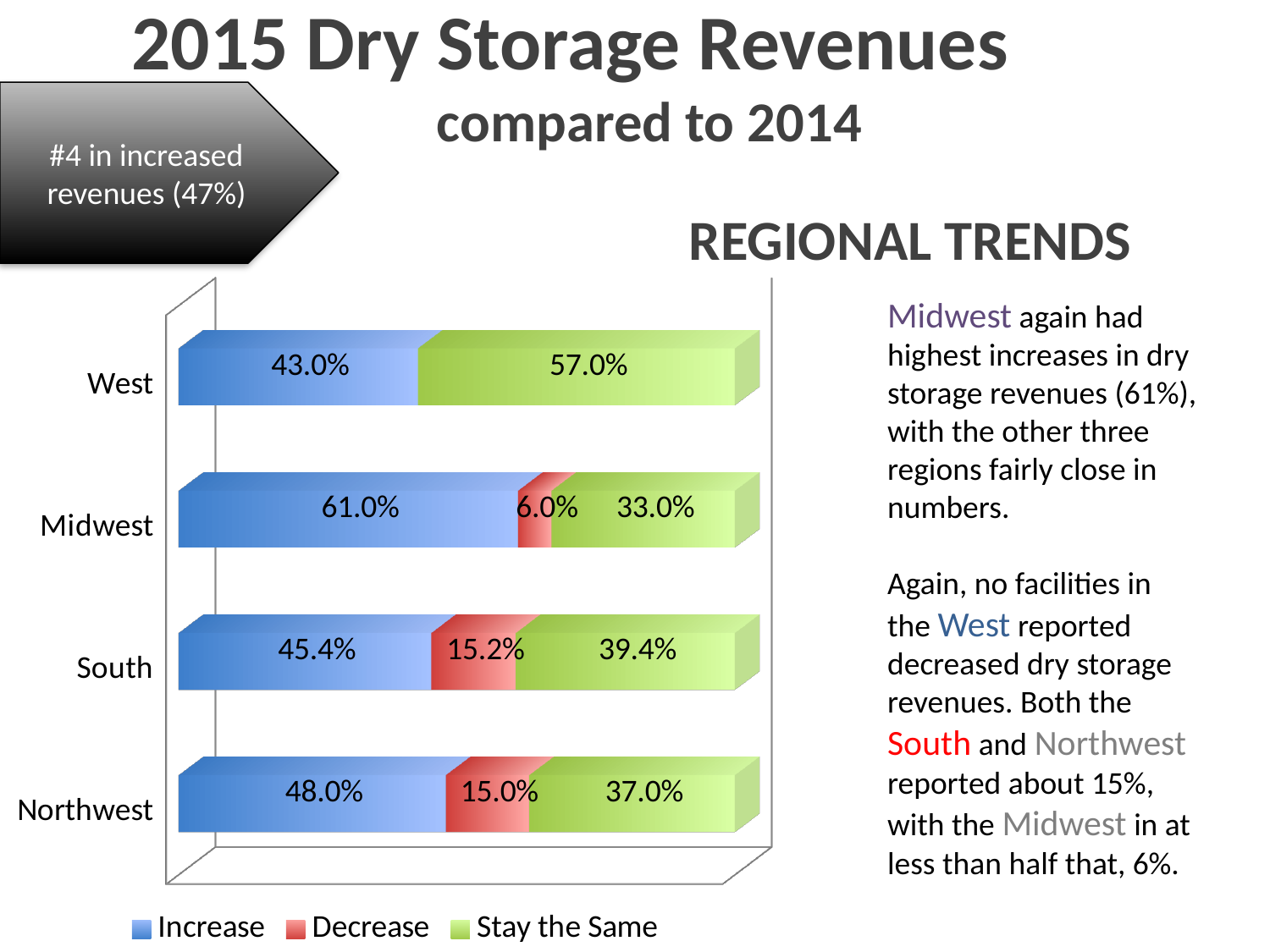
What percentage of facilities in the Midwest reported an increase in dry storage revenues? 61.0% Which region has the highest Increase value? Midwest What is the Stay the Same value for the West? 57.0% Which colour represents the Decrease series in the chart? Red Which is larger, the Stay the Same value for the South or for the Northwest? South How many series does the legend list? 3 What is the Decrease value for the South? 15.2% Which region has the lowest Increase value? West What kind of chart is shown on the slide? Stacked bar chart What is the difference between the Increase values for the Midwest and the West? 18.0% What is the Increase value for the Northwest? 48.0% How many regions are shown in the chart? 4